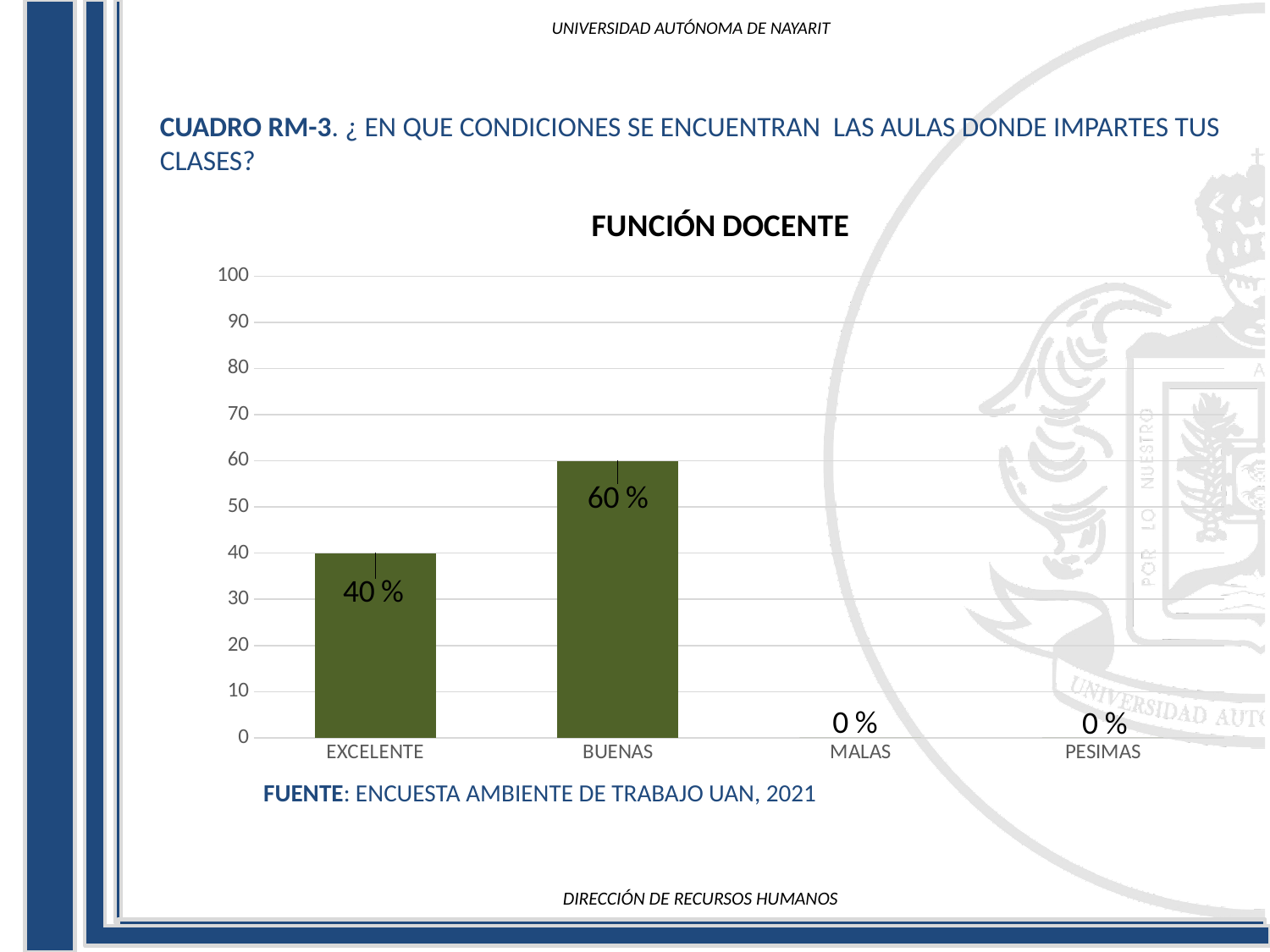
What is the value for MALAS? 0 % What is the title of the chart? FUNCIÓN DOCENTE How many categories are shown on the x axis? 4 Is the value for BUENAS greater or less than 50? greater What kind of chart is shown on the slide? bar chart Which is larger, the value for EXCELENTE or the value for BUENAS? BUENAS What is the value for EXCELENTE? 40 % What is the highest value shown on the y axis? 100 What is the difference between the values for BUENAS and EXCELENTE? 20 % What is the value for BUENAS? 60 % What is the value for PESIMAS? 0 % Which category has the highest value? BUENAS